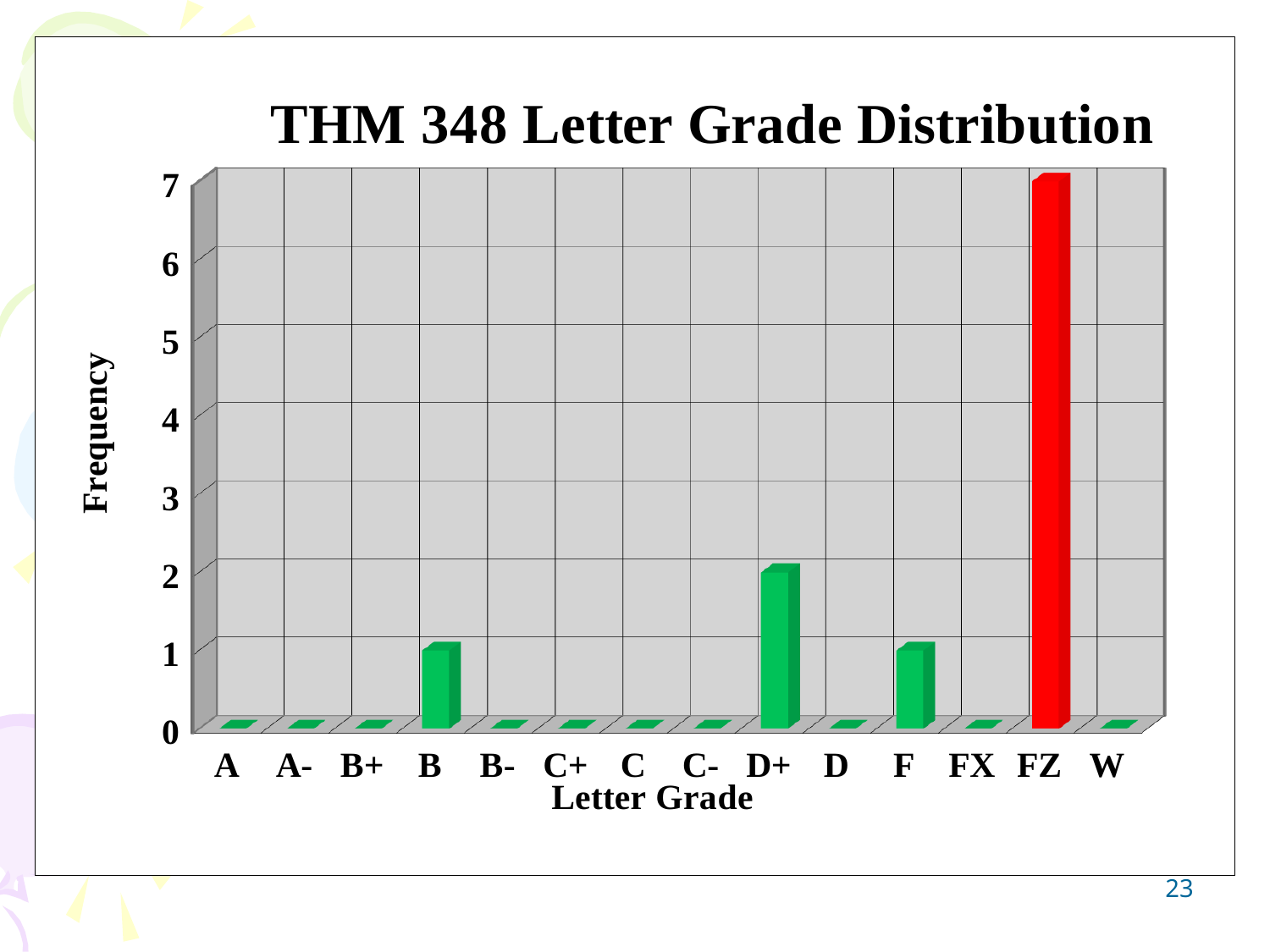
Which has a higher frequency, D+ or B? D+ What type of chart is shown on the slide? bar chart What is the frequency for the B grade? 1 What is the title of the chart? THM 348 Letter Grade Distribution What is the label of the y axis? Frequency How many letter grade categories are shown on the x axis? 14 What is the difference in frequency between FZ and D+? 5 Which letter grade has the highest frequency? FZ Is the frequency for FZ greater or less than 5? greater What is the frequency for the FZ grade? 7 What is the frequency for the F grade? 1 What is the frequency for the D+ grade? 2